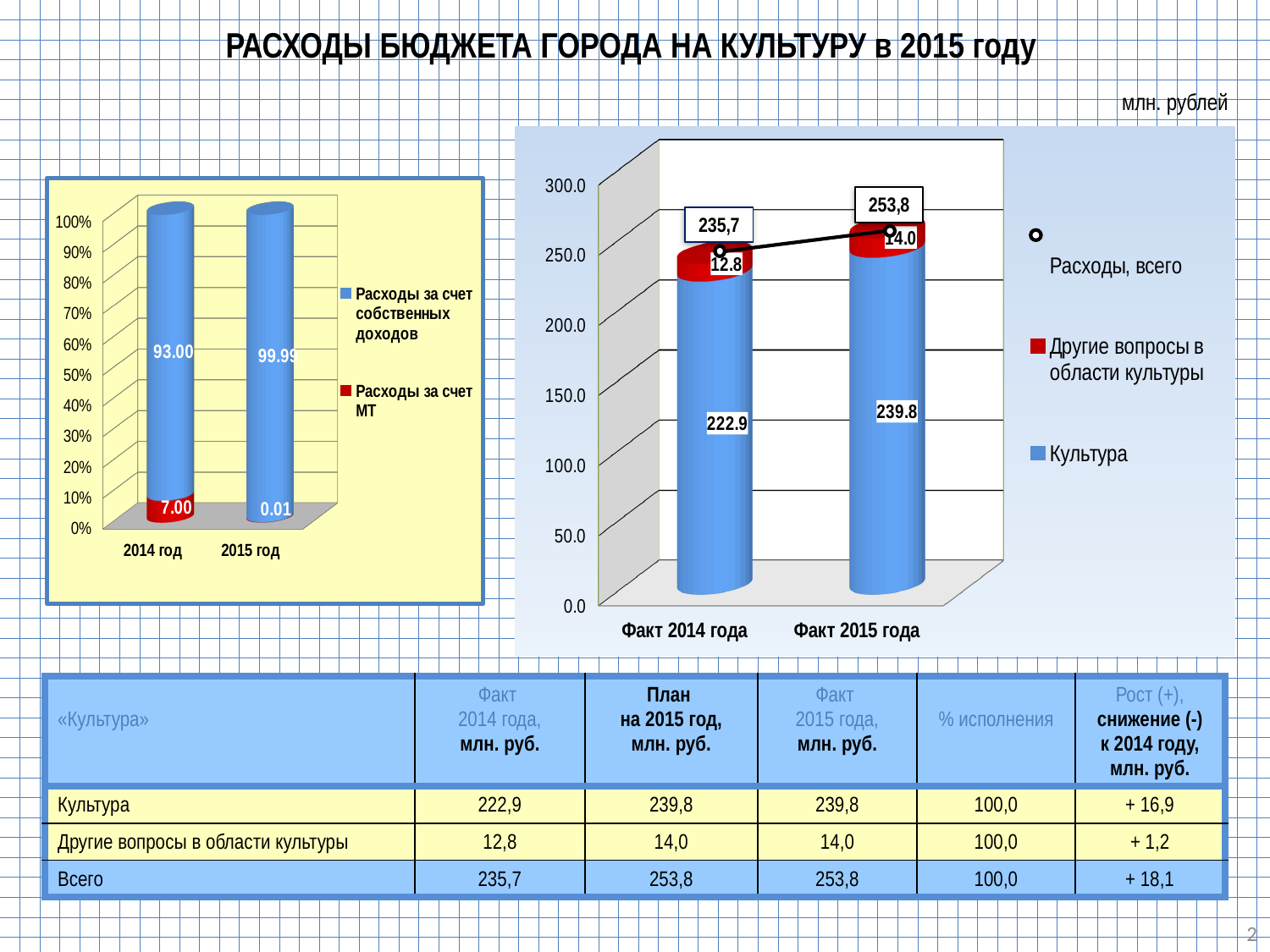
In the right-hand chart, what is the difference between the Культура values for Факт 2015 года and Факт 2014 года? 16.9 In the left-hand chart, what is the value for Расходы за счет МТ for 2015 год? 0.01 In the right-hand chart, does the total Расходы, всего rise or fall from Факт 2014 года to Факт 2015 года? rise In the left-hand chart, which year has the higher value for Расходы за счет МТ? 2014 год In the right-hand chart, which category has the higher Культура value, Факт 2014 года or Факт 2015 года? Факт 2015 года In the right-hand chart, what is the total (Расходы, всего) shown for Факт 2015 года? 253,8 What kind of chart is the left-hand chart? bar chart In the left-hand chart, what is the value for Расходы за счет собственных доходов for 2014 год? 93.00 In the right-hand chart, what is the value for Культура for Факт 2015 года? 239.8 How many series does the legend of the right-hand chart list? 3 How many categories are shown on the x axis of the left-hand chart? 2 In the right-hand chart, what is the value for Другие вопросы в области культуры for Факт 2014 года? 12.8